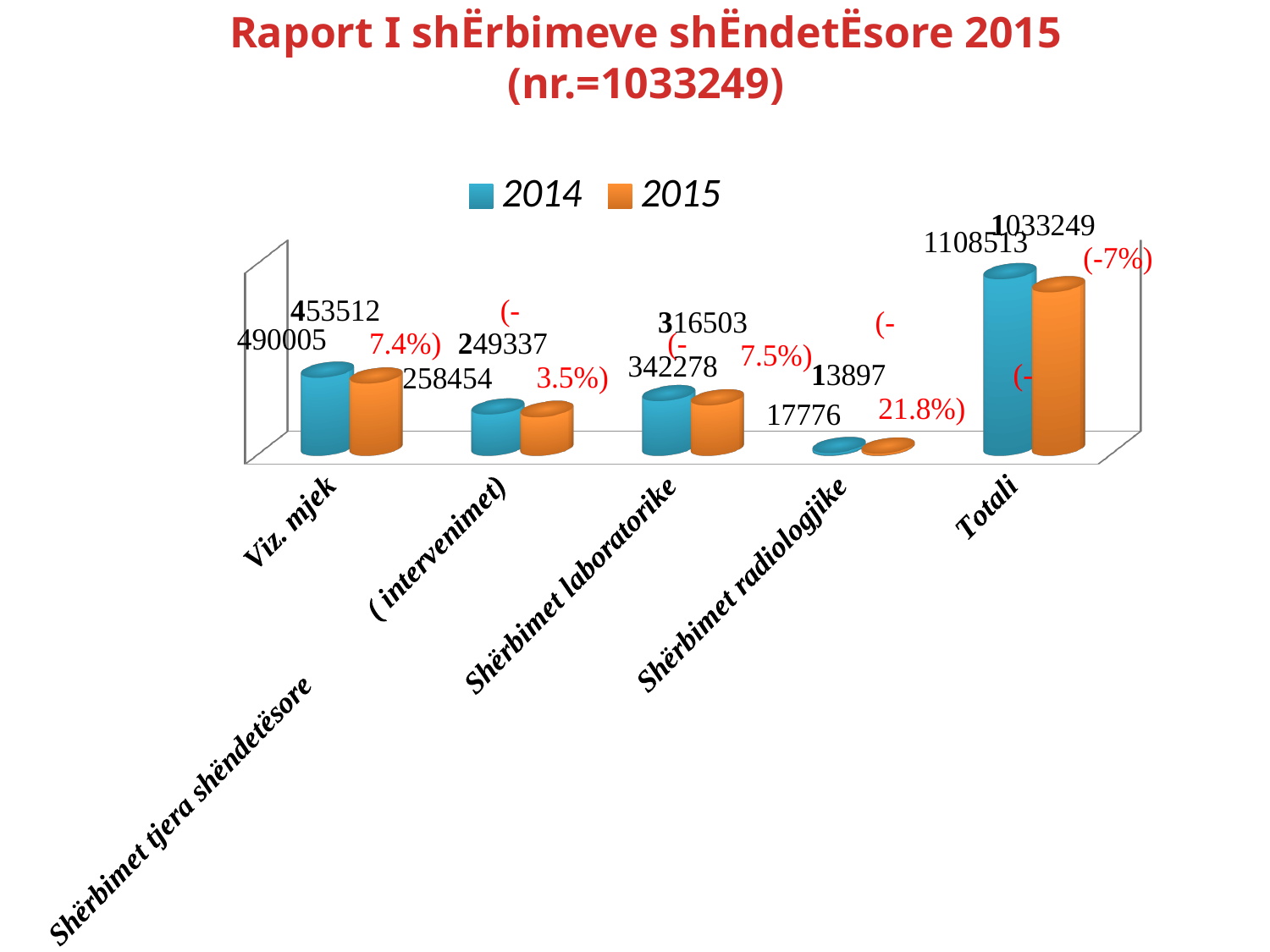
How many series does the legend list? 2 Excluding Totali, which category has the lowest 2015 value? Shërbimet radiologjike What is the 2015 value for Shërbimet laboratorike? 316503 What is the difference between the 2014 and 2015 values for Shërbimet laboratorike? 25775 What is the 2014 value for Shërbimet radiologjike? 17776 What is the 2015 value for Totali? 1033249 What percentage change is shown for Shërbimet radiologjike? -21.8% Excluding Totali, which category has the highest 2014 value? Viz. mjek What is the 2015 value for Viz. mjek? 453512 What kind of chart is shown on the slide? Bar chart What is the 2014 value for Viz. mjek? 490005 Which is larger for Viz. mjek, the 2014 value or the 2015 value? 2014